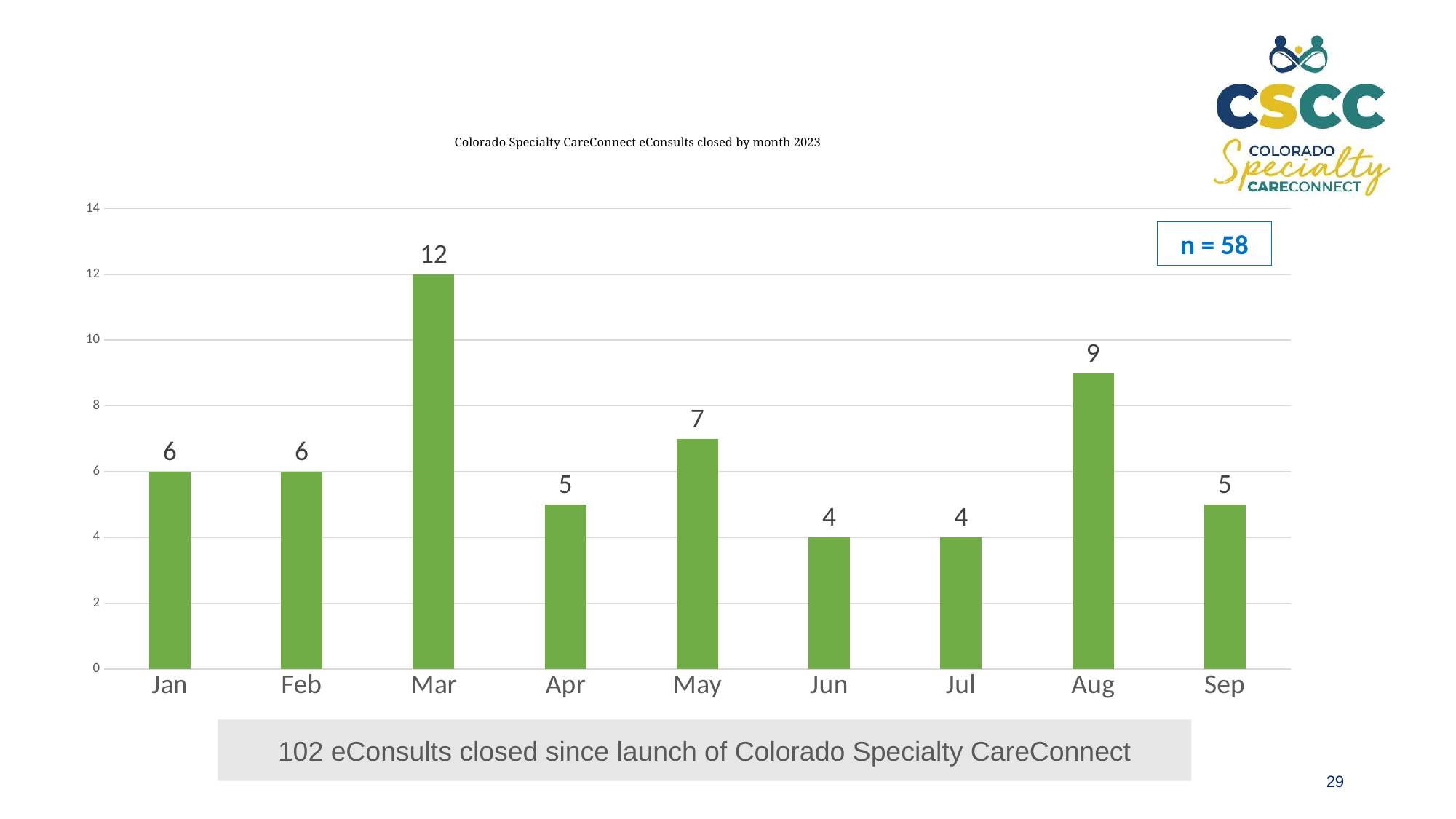
Which months have the lowest value on the chart? Jun and Jul What is the value for August? 9 What is the difference between the values for May and April? 2 What kind of chart is shown on the slide? Bar chart Which month has the highest number of eConsults closed? Mar Do the values rise or fall from March to April? Fall How many eConsults were closed in June? 4 Which is larger, the value for May or the value for September? May What is the title of the chart? Colorado Specialty CareConnect eConsults closed by month 2023 How many eConsults were closed in March? 12 How many months are shown on the x axis? 9 What is the difference between the values for March and August? 3